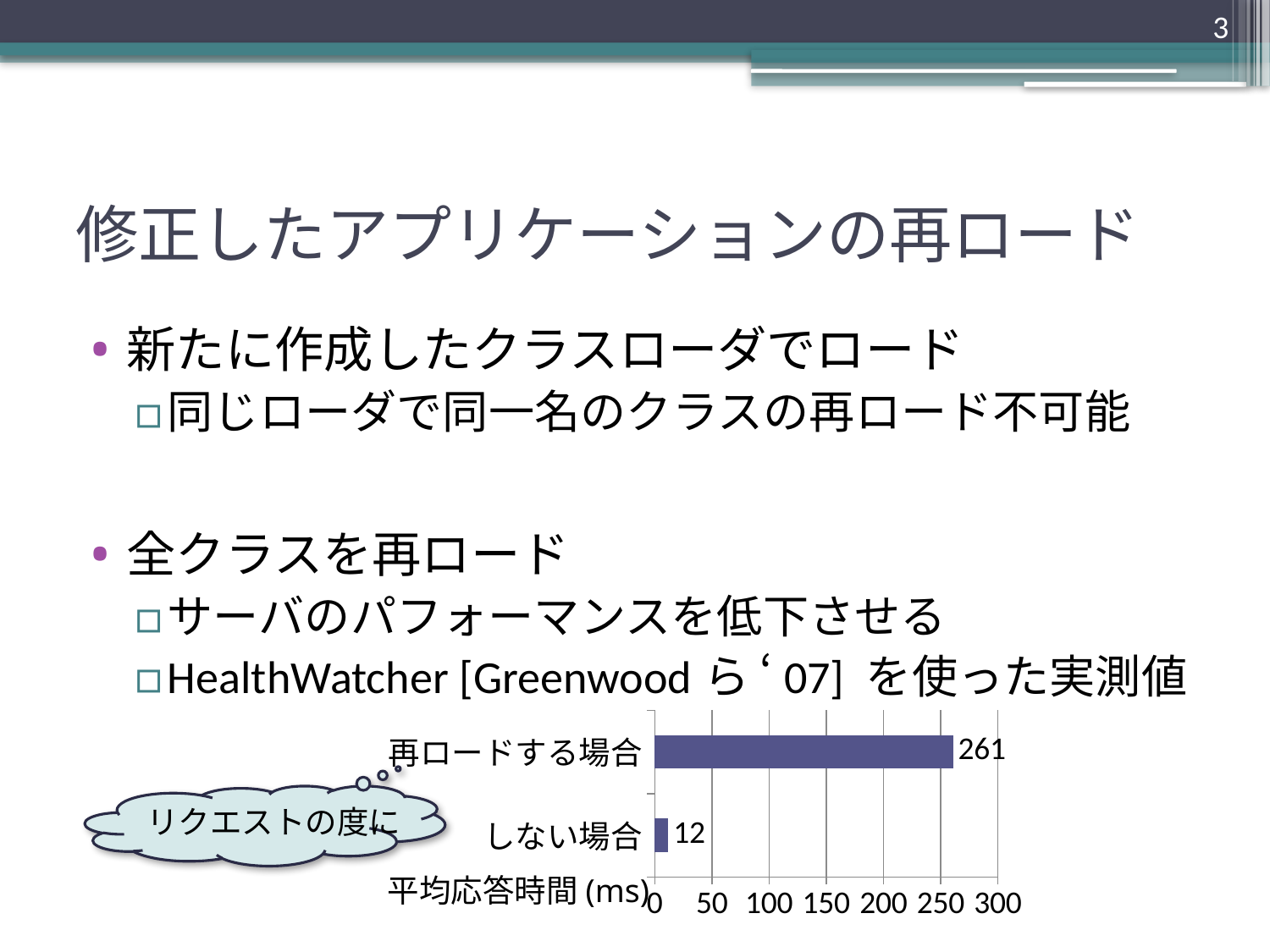
Which category has the highest value in the chart? 再ロードする場合 Is the value for しない場合 greater or less than 50? less What is the maximum value shown on the horizontal axis of the chart? 300 Is the value for 再ロードする場合 greater or less than 250? greater What is the label of the horizontal axis of the chart? 平均応答時間 (ms) Which is larger, the value for 再ロードする場合 or for しない場合? 再ロードする場合 What kind of chart is shown on the slide? bar chart Which category has the lowest value in the chart? しない場合 What is the average response time for しない場合? 12 How many categories are shown in the chart? 2 What is the difference between the values for 再ロードする場合 and しない場合? 249 What is the average response time for 再ロードする場合? 261